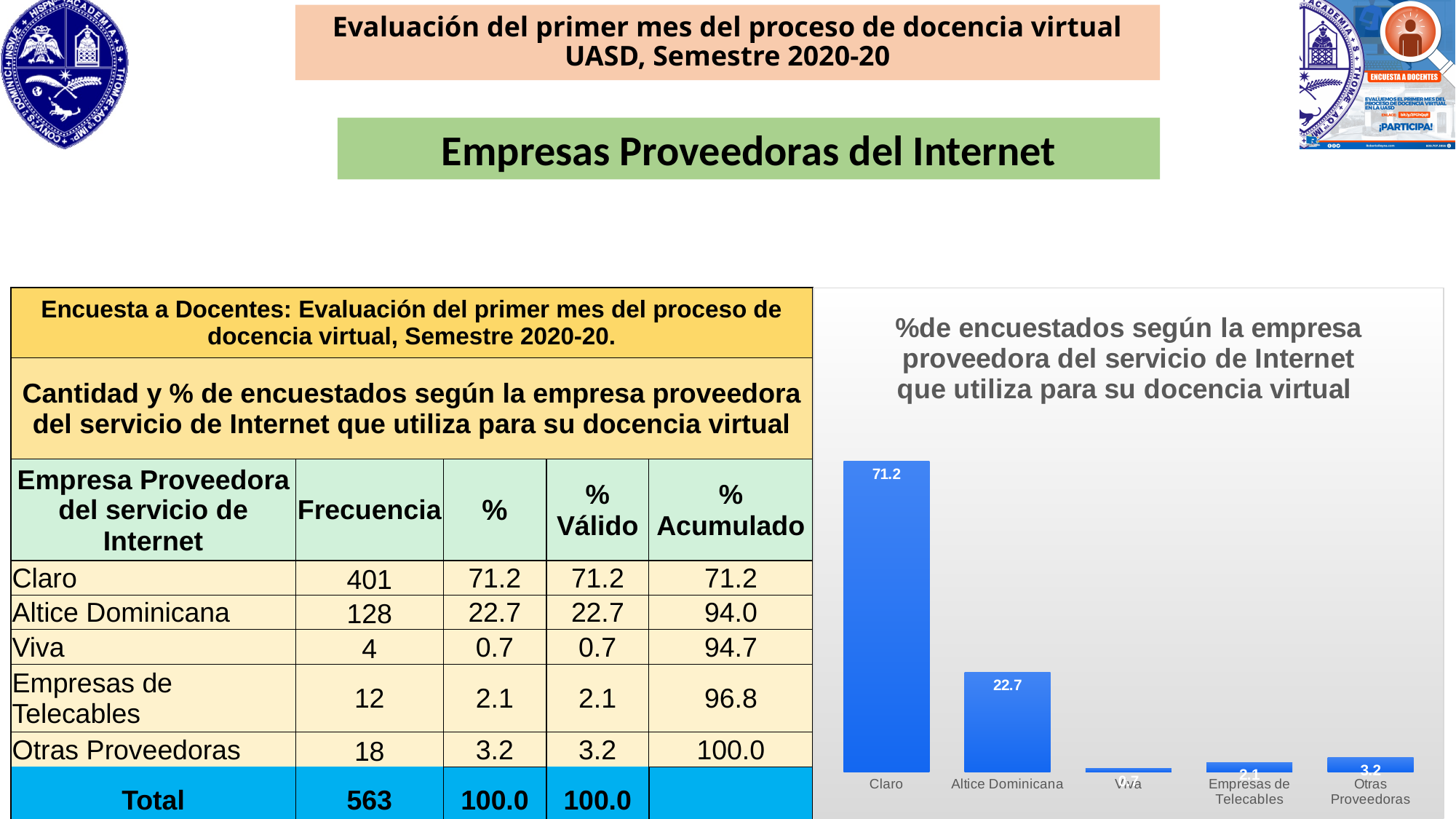
Which is larger in the bar chart, the value for Otras Proveedoras or the value for Altice Dominicana? Altice Dominicana What is the value for Otras Proveedoras in the bar chart? 3.2 What is the difference between the values for Claro and Altice Dominicana in the bar chart? 48.5 Which category has the highest value in the bar chart? Claro What is the value for Claro in the bar chart? 71.2 Do the values in the bar chart generally rise or fall from Claro to Altice Dominicana to Viva? fall What is the title of the bar chart? %de encuestados según la empresa proveedora del servicio de Internet que utiliza para su docencia virtual What colour are the bars in the bar chart? blue Which category has the lowest value in the bar chart? Viva How many categories are shown in the bar chart? 5 What is the value for Altice Dominicana in the bar chart? 22.7 What type of chart is shown on the slide? bar chart